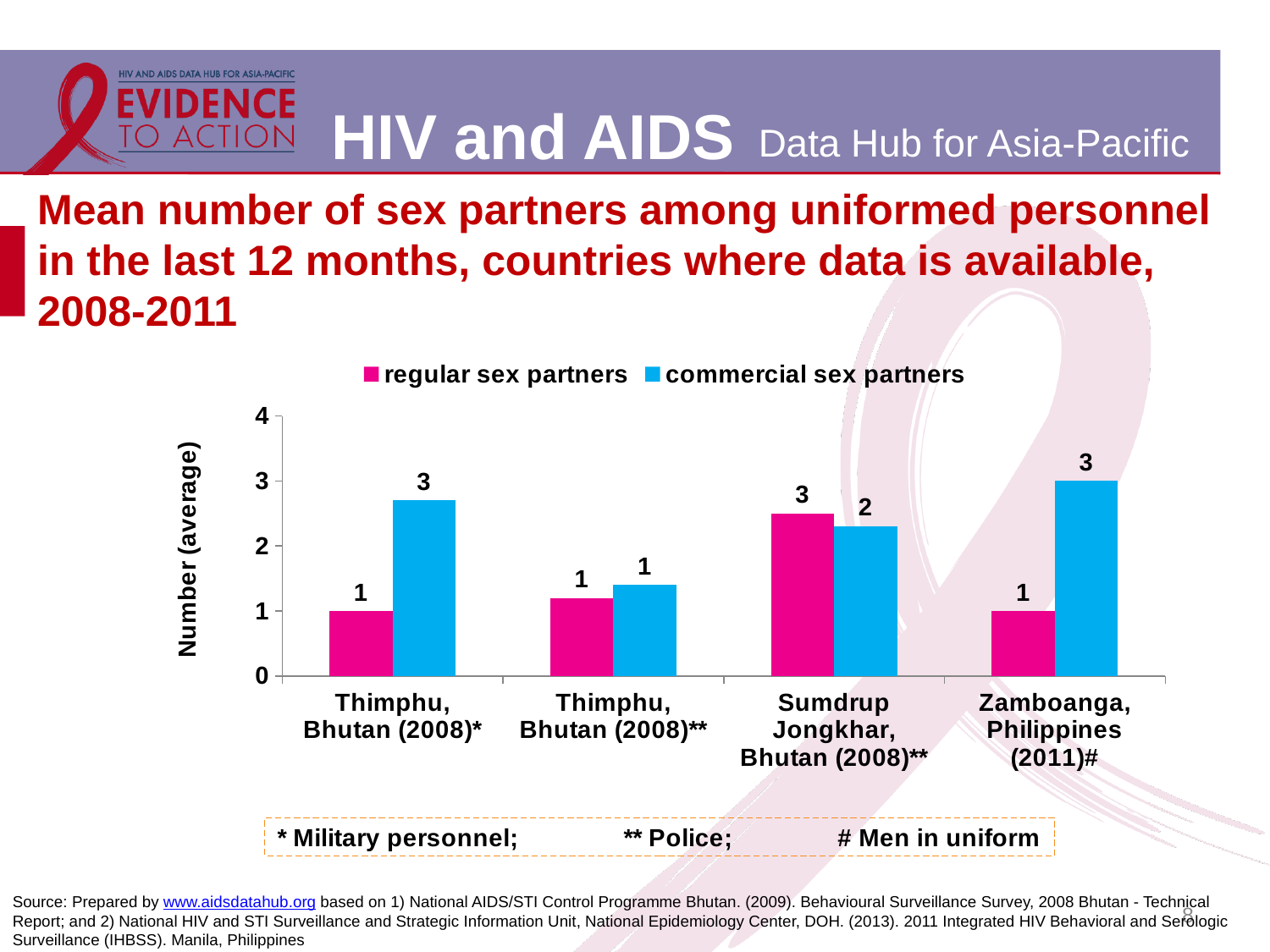
Is the value for commercial sex partners in Thimphu, Bhutan (2008)** greater or less than 2? less How many locations are shown on the x axis? 4 How many series does the legend list? 2 Which location has the highest value for regular sex partners? Sumdrup Jongkhar, Bhutan (2008)** What kind of chart is shown on the slide? bar chart Which location has the lowest value for commercial sex partners? Thimphu, Bhutan (2008)** In Zamboanga, Philippines (2011)#, what is the difference between the labelled values for commercial sex partners and regular sex partners? 2 What is the data label for regular sex partners in Sumdrup Jongkhar, Bhutan (2008)**? 3 What is the data label for commercial sex partners in Zamboanga, Philippines (2011)#? 3 What is the data label for regular sex partners in Thimphu, Bhutan (2008)*? 1 In Thimphu, Bhutan (2008)*, which is larger: regular sex partners or commercial sex partners? commercial sex partners What is the data label for commercial sex partners in Thimphu, Bhutan (2008)*? 3